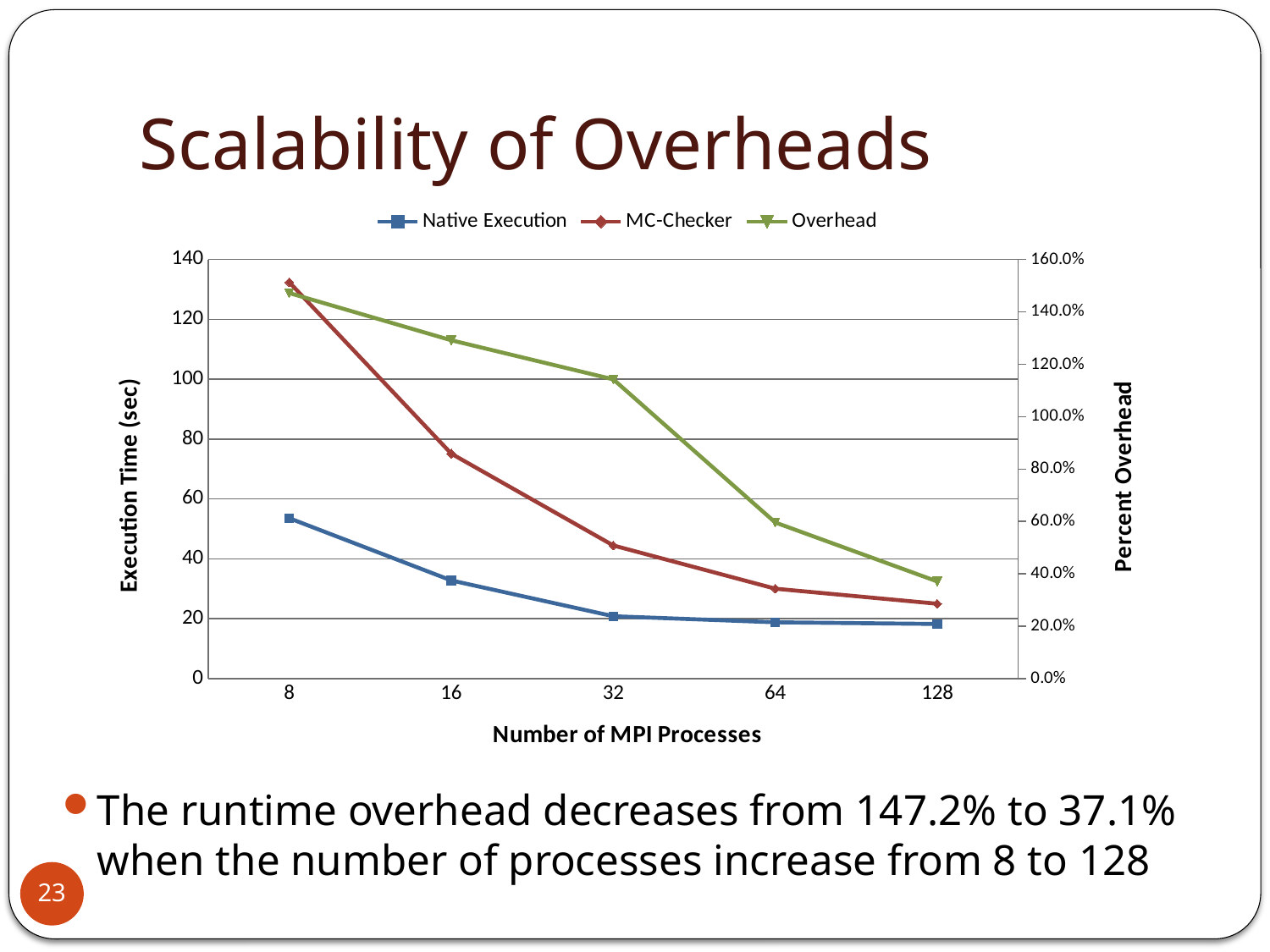
How many values of Number of MPI Processes are plotted on the x axis? 5 At which number of MPI processes is the MC-Checker execution time highest? 8 Does the MC-Checker execution time rise or fall as the number of MPI processes increases? fall How many series does the legend list? 3 According to the slide, what is the runtime overhead at 8 processes? 147.2% According to the slide, what is the runtime overhead at 128 processes? 37.1% What kind of chart is shown on the slide? line chart Is the MC-Checker execution time at 8 processes greater or less than 120 seconds? greater At 32 MPI processes, which is larger: the MC-Checker execution time or the Native Execution time? MC-Checker What is the label of the right-hand vertical axis? Percent Overhead At which number of MPI processes is the Overhead percentage lowest? 128